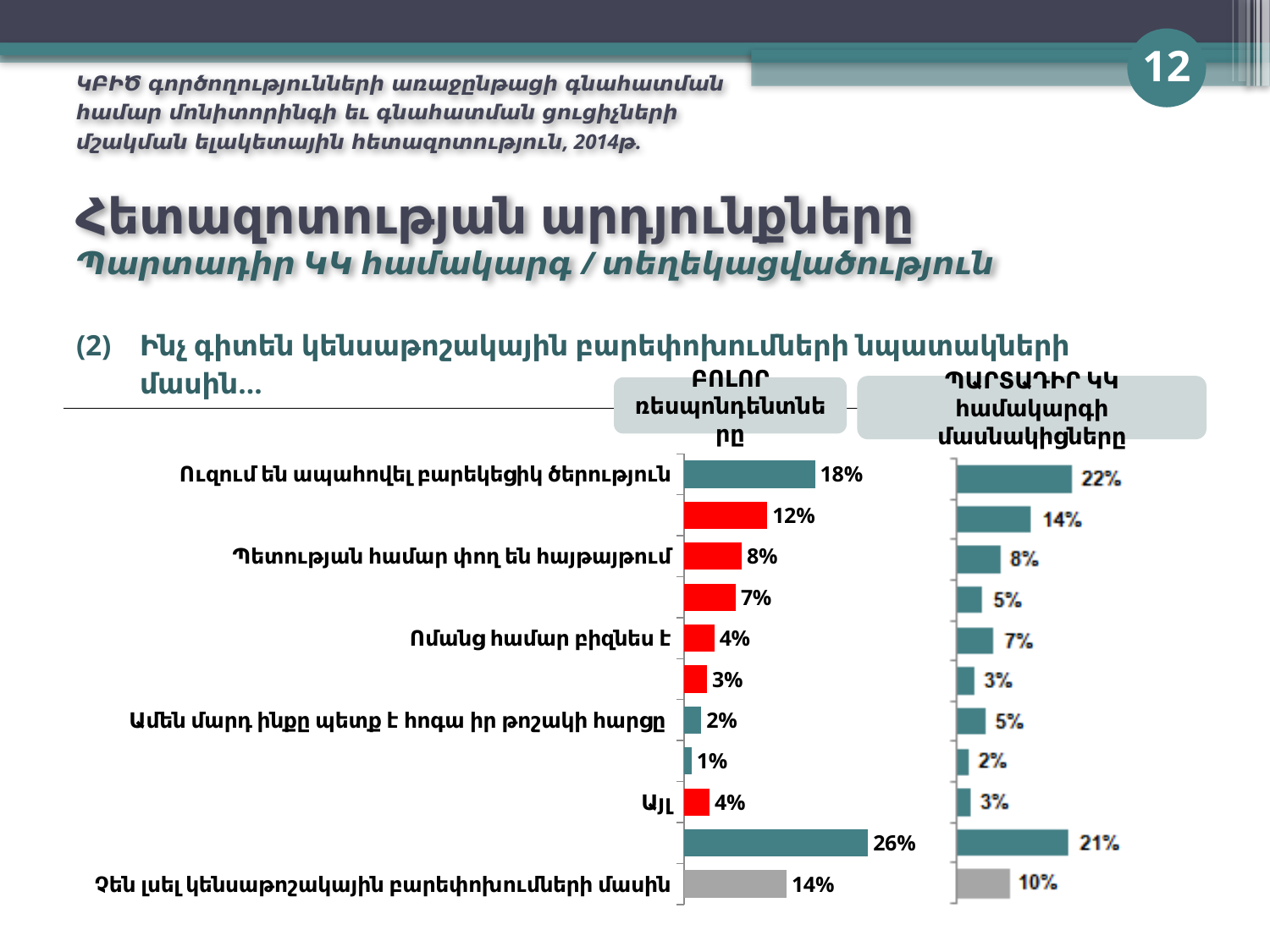
What is the difference between the values for "Ուզում են ապահովել բարեկեցիկ ծերություն" in the right chart (22%) and the left chart (18%)? 4% In the right chart (ՊԱՐՏԱԴԻՐ ԿԿ համակարգի մասնակիցները), what is the value for "Ոմանց համար բիզնես է"? 7% What is the highest value shown in the left chart (ԲՈԼՈՐ ռեսպոնդենտները)? 26% In the left chart (ԲՈԼՈՐ ռեսպոնդենտները), what is the value for "Ամեն մարդ ինքը պետք է հոգա իր թոշակի հարցը"? 2% Which chart shows a larger value for "Չեն լսել կենսաթոշակային բարեփոխումների մասին": the left chart (ԲՈԼՈՐ ռեսպոնդենտները) or the right chart (ՊԱՐՏԱԴԻՐ ԿԿ համակարգի մասնակիցները)? The left chart (ԲՈԼՈՐ ռեսպոնդենտները) In the left chart (ԲՈԼՈՐ ռեսպոնդենտները), what is the value for "Չեն լսել կենսաթոշակային բարեփոխումների մասին"? 14% What type of chart is used on this slide? Bar chart In the right chart (ՊԱՐՏԱԴԻՐ ԿԿ համակարգի մասնակիցները), what is the value for "Այլ"? 3% What is the lowest value shown in the right chart (ՊԱՐՏԱԴԻՐ ԿԿ համակարգի մասնակիցները)? 2% In the left chart (ԲՈԼՈՐ ռեսպոնդենտները), what is the value for "Ուզում են ապահովել բարեկեցիկ ծերություն"? 18% How many bars are plotted in the left chart (ԲՈԼՈՐ ռեսպոնդենտները)? 11 In the right chart (ՊԱՐՏԱԴԻՐ ԿԿ համակարգի մասնակիցները), what is the value for "Ուզում են ապահովել բարեկեցիկ ծերություն"? 22%